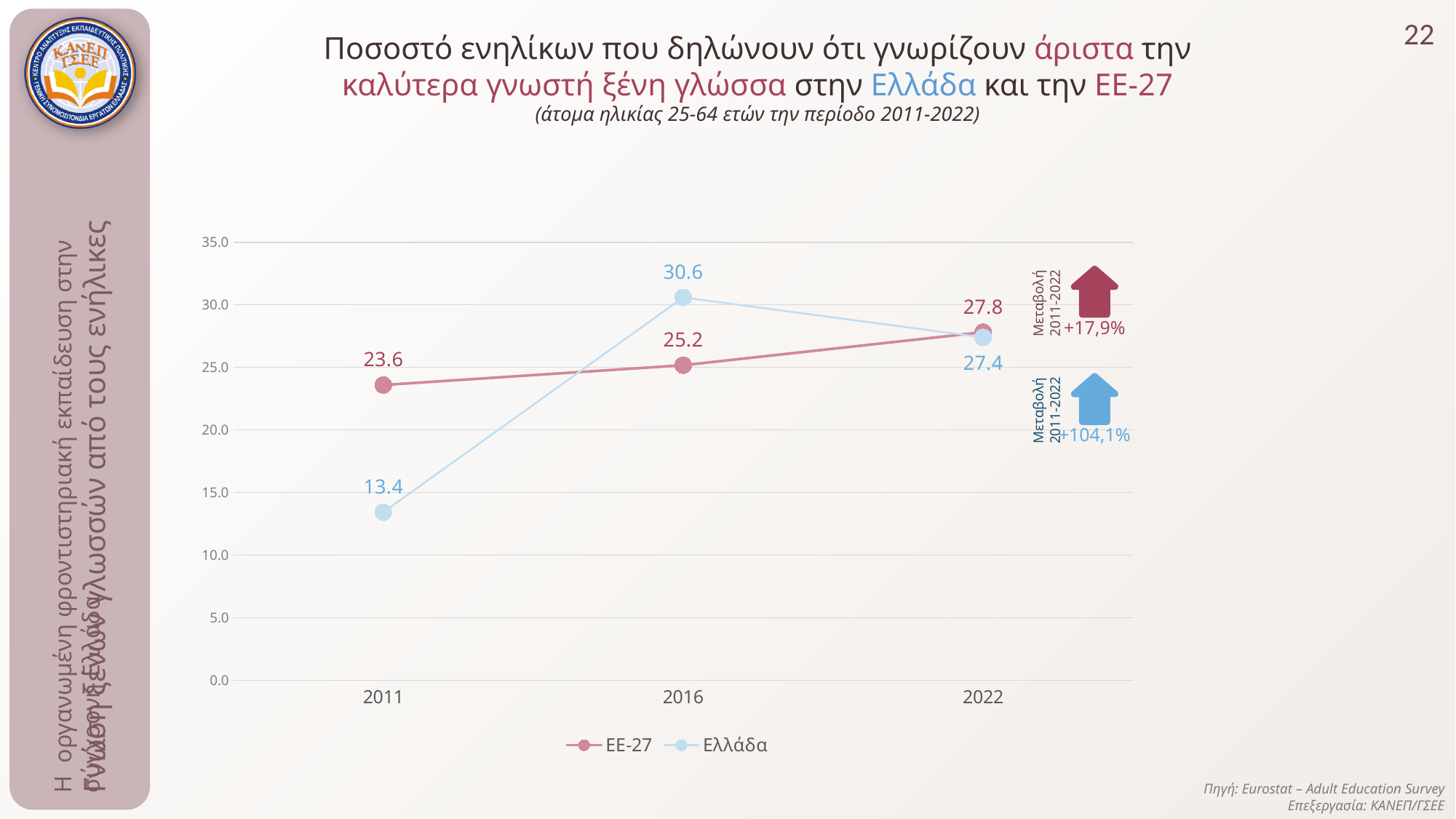
In which year is the value for ΕΕ-27 lowest? 2011 What percentage change for 2011-2022 is shown next to the blue arrow for Ελλάδα? +104,1% What type of chart is shown on the slide? line chart How many series does the legend list? 2 What is the value for Ελλάδα in 2011? 13.4 In which year is the value for Ελλάδα highest? 2016 Which series has the larger value in 2011, ΕΕ-27 or Ελλάδα? ΕΕ-27 How many years are plotted on the x axis? 3 What is the value for ΕΕ-27 in 2016? 25.2 What is the difference between the Ελλάδα and ΕΕ-27 values in 2016? 5.4 Does the ΕΕ-27 series rise or fall from 2011 to 2022? rise What is the value for Ελλάδα in 2022? 27.4